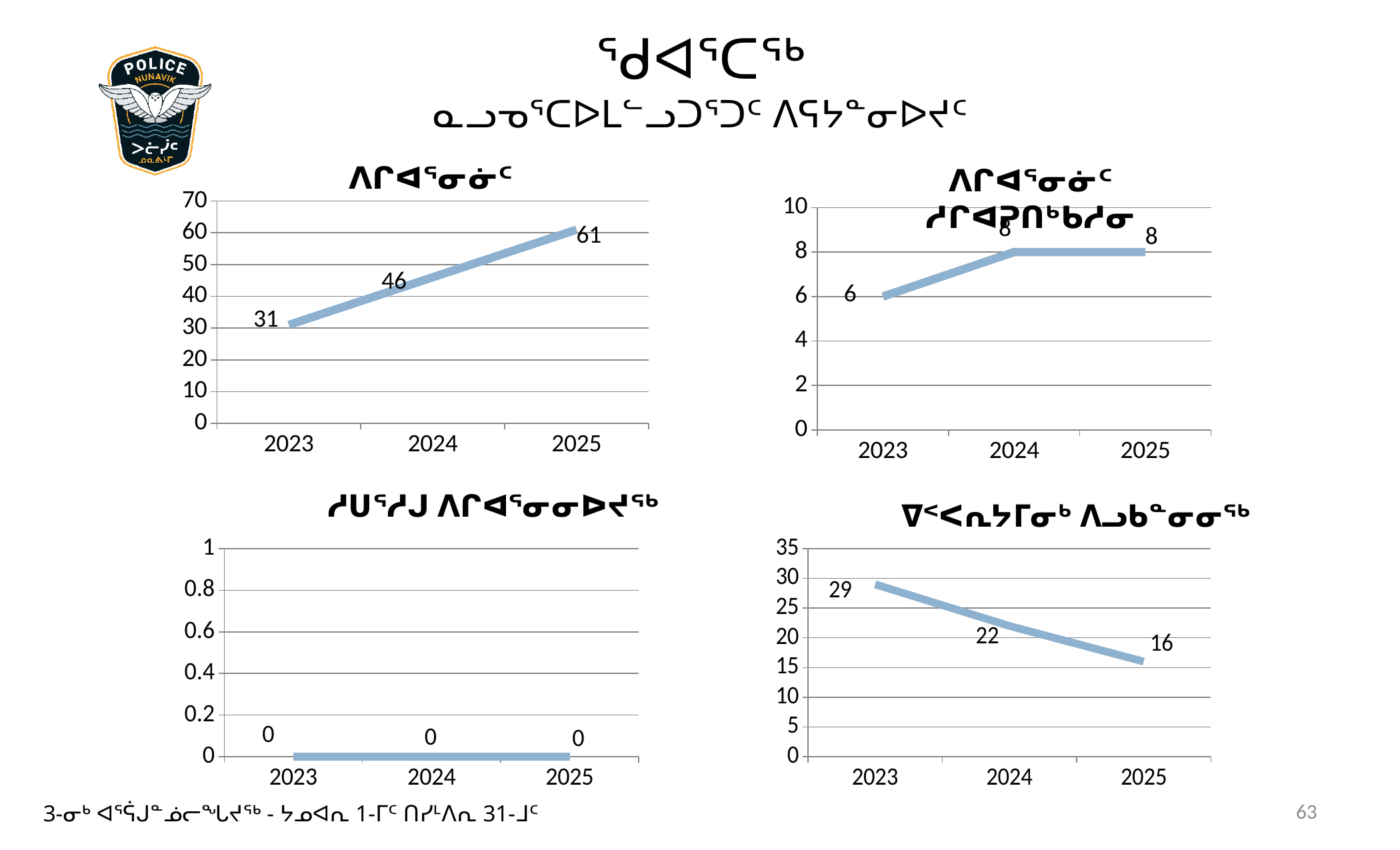
What kind of chart is the bottom-right chart? line chart In the top-left chart, what is the value for 2024? 46 In the top-left chart, what is the difference between the 2025 and 2023 values? 30 In the bottom-right chart, what is the value for 2023? 29 In the top-right chart, what is the value for 2023? 6 In the top-right chart, which year has the lowest value? 2023 In the bottom-right chart, what is the difference between the 2023 and 2025 values? 13 In the bottom-right chart, which year has the highest value? 2023 In the top-right chart, what is the value for 2025? 8 In the top-left chart, what is the value for 2025? 61 In the top-left chart, do the values rise or fall from 2023 to 2025? rise In the bottom-left chart, what is the value for 2024? 0